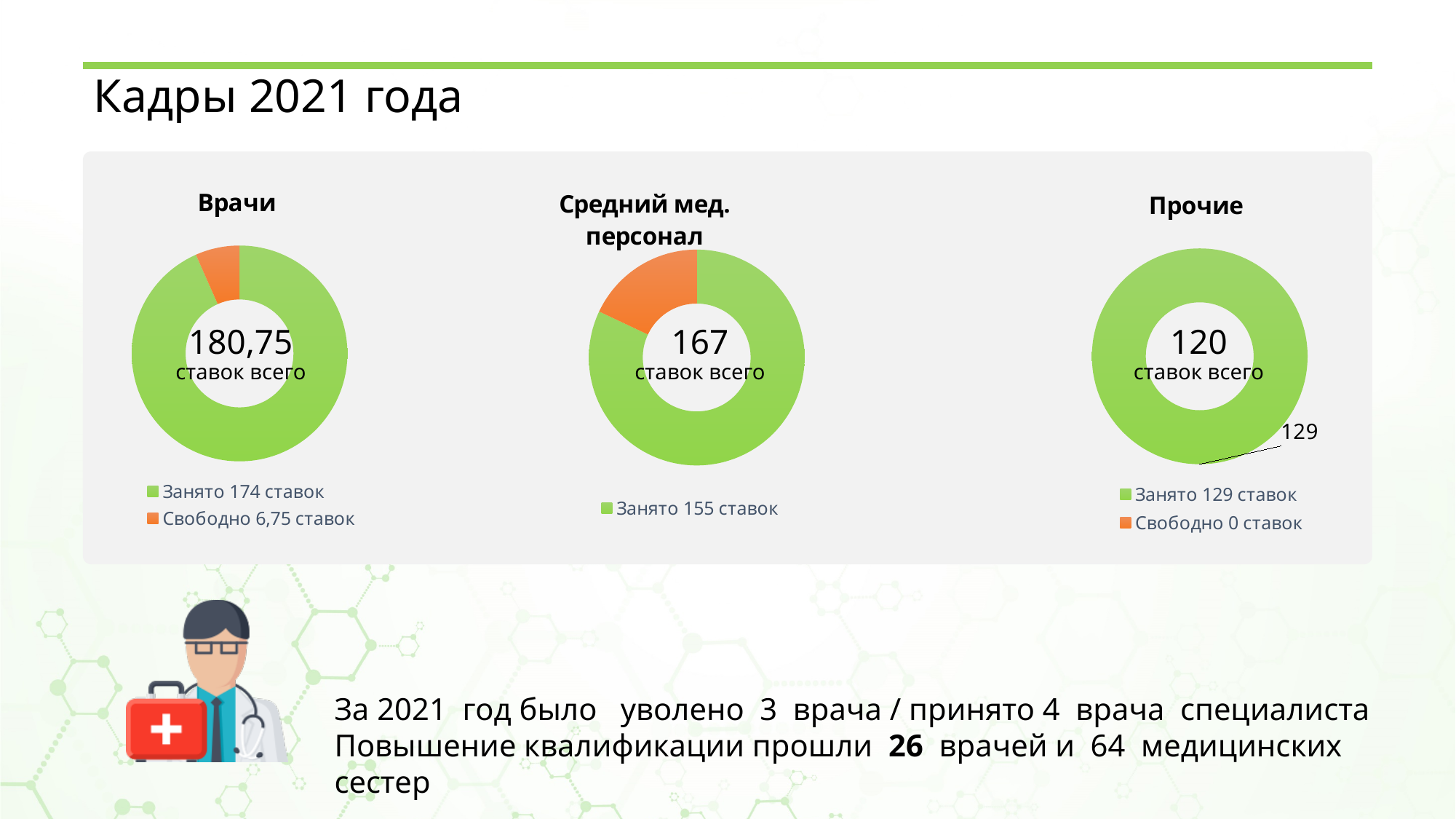
In the "Врачи" chart, how many positions are occupied (Занято) according to the legend? 174 ставок In the "Средний мед. персонал" chart, what total is shown in the centre? 167 ставок всего What kind of chart is used for "Врачи" on the slide? Doughnut (pie) chart In the "Прочие" chart, how many positions are free (Свободно) according to the legend? 0 ставок In the "Прочие" chart, what total is shown in the centre? 120 ставок всего In the "Врачи" chart, which segment is larger: Занято or Свободно? Занято What colour represents the occupied (Занято) positions in the charts? Green In the "Средний мед. персонал" chart, how many positions are occupied (Занято) according to the legend? 155 ставок In the "Врачи" chart, what is the total number of positions shown in the centre? 180,75 ставок всего How many entries does the legend of the "Средний мед. персонал" chart list? 1 How many charts are shown on the slide? 3 In the "Врачи" chart, how many positions are free (Свободно) according to the legend? 6,75 ставок